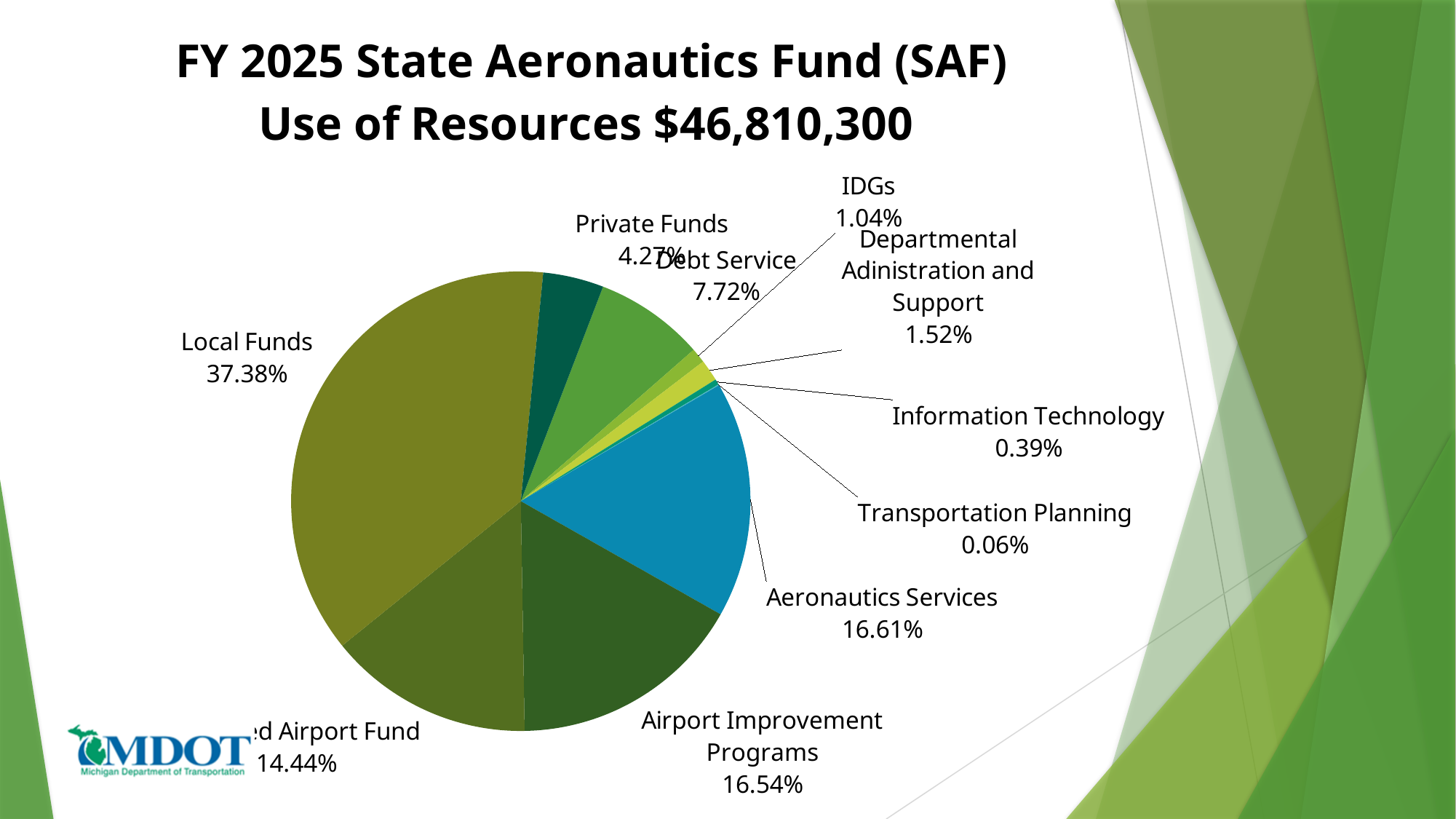
What is the value shown for Information Technology? 0.39% Which is larger, Debt Service or Private Funds? Debt Service Which category has the smallest share of the pie? Transportation Planning What percentage of the pie is Local Funds? 37.38% What total dollar amount is stated in the chart title? $46,810,300 What is the difference in percentage points between Aeronautics Services and Airport Improvement Programs? 0.07% What type of chart is shown on the slide? pie chart Which category has the largest share of the pie? Local Funds What is the value shown for Aeronautics Services? 16.61% What is the value shown for Debt Service? 7.72% What share of the pie does Private Funds represent? 4.27% What is the difference in percentage points between Local Funds and Aeronautics Services? 20.77%